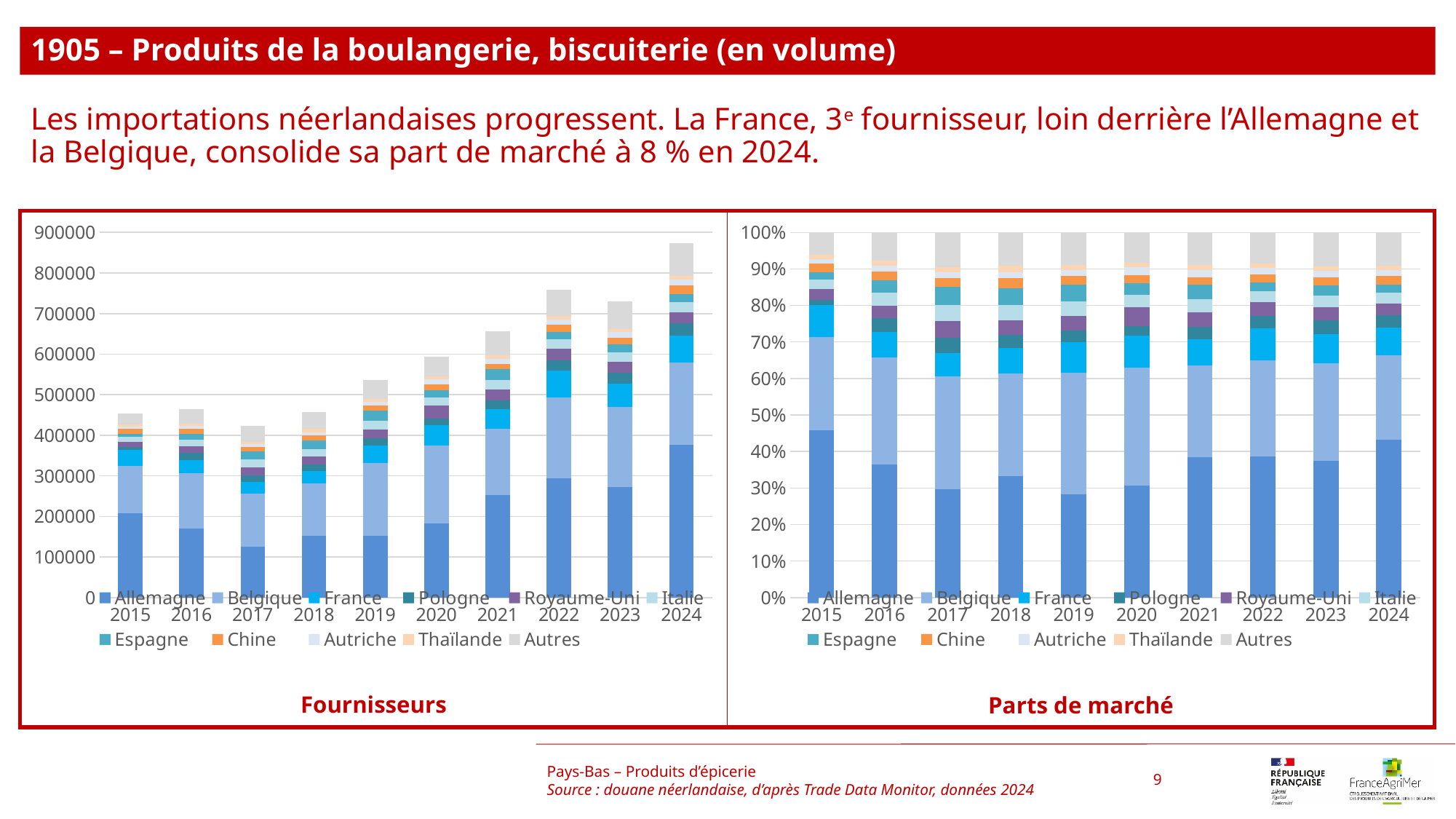
How many years are shown on the x axis of the "Fournisseurs" chart? 10 What kind of chart is the left chart titled "Fournisseurs"? stacked bar chart In the "Fournisseurs" chart, is the total bar higher in 2022 or in 2023? 2022 In the "Fournisseurs" chart, which year has the tallest total bar? 2024 In the "Fournisseurs" chart, do the total bars generally rise or fall from 2015 to 2024? rise In the "Fournisseurs" chart, is the total bar for 2017 greater or less than 500000? less What is the title of the right chart? Parts de marché In the "Fournisseurs" chart, is the total bar for 2024 greater or less than 800000? greater In the "Parts de marché" chart, is the Allemagne share in 2015 greater or less than 40%? greater How many series does the legend of the "Parts de marché" chart list? 11 In the "Fournisseurs" chart, which year has the lowest total bar? 2017